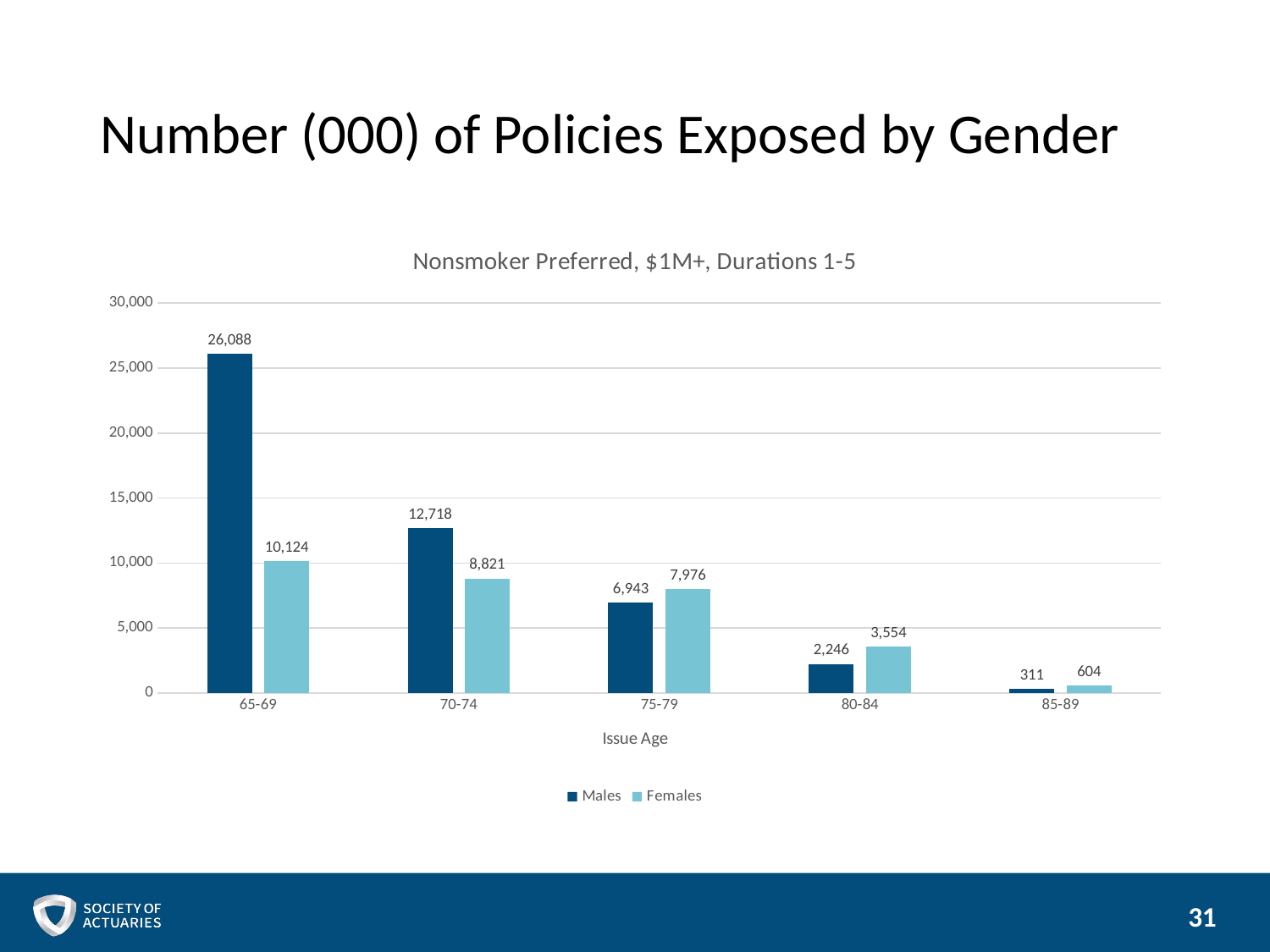
How many series does the legend list? 2 What is the difference between the Males and Females values in the 65-69 issue age group? 15,964 What is the value for Females in the 70-74 issue age group? 8,821 Do the Males values rise or fall as issue age increases along the x axis? Fall What is the value for Males in the 65-69 issue age group? 26,088 Which issue age group has the highest value for Males? 65-69 What is the value for Females in the 80-84 issue age group? 3,554 Is the value for Males in the 70-74 issue age group greater or less than 10,000? greater What kind of chart is shown on the slide? Bar chart Which issue age group has the lowest value for Females? 85-89 How many issue age groups are shown on the x axis? 5 In the 75-79 issue age group, which is larger, Males or Females? Females